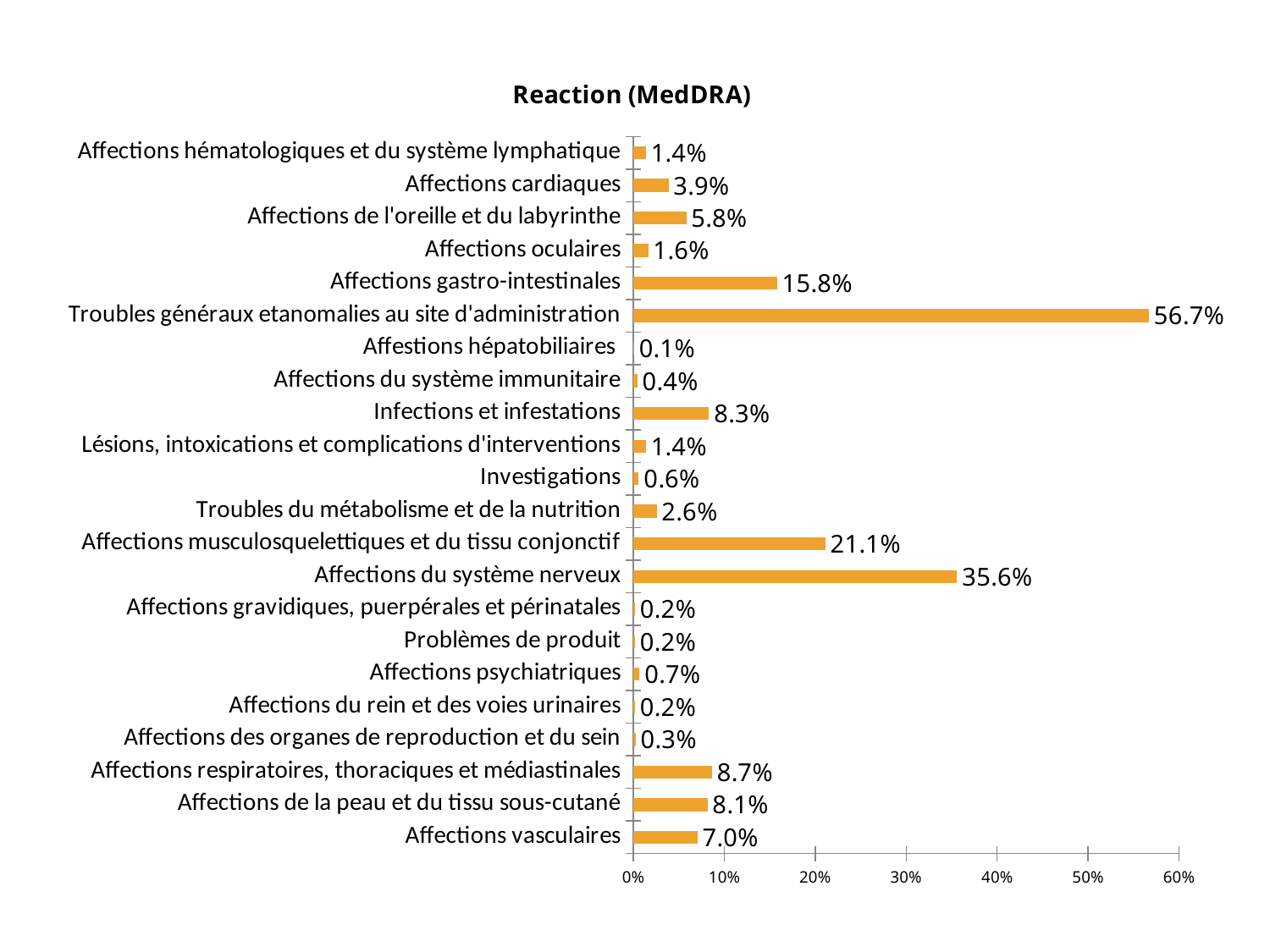
What is the value for Affections gastro-intestinales? 15.8% Which category has the lowest value? Affestions hépatobiliaires What is the title of the chart? Reaction (MedDRA) Which category has the highest value? Troubles généraux etanomalies au site d'administration What is the value for Affections du système nerveux? 35.6% Which is larger, Affections cardiaques or Affections de l'oreille et du labyrinthe? Affections de l'oreille et du labyrinthe Which is larger, Infections et infestations or Affections vasculaires? Infections et infestations What is the difference between Troubles généraux etanomalies au site d'administration and Affections du système nerveux? 21.1% What is the value for Affections respiratoires, thoraciques et médiastinales? 8.7% What kind of chart is this? Bar chart What is the difference between Affections musculosquelettiques et du tissu conjonctif and Affections gastro-intestinales? 5.3% How many categories are shown in the chart? 22